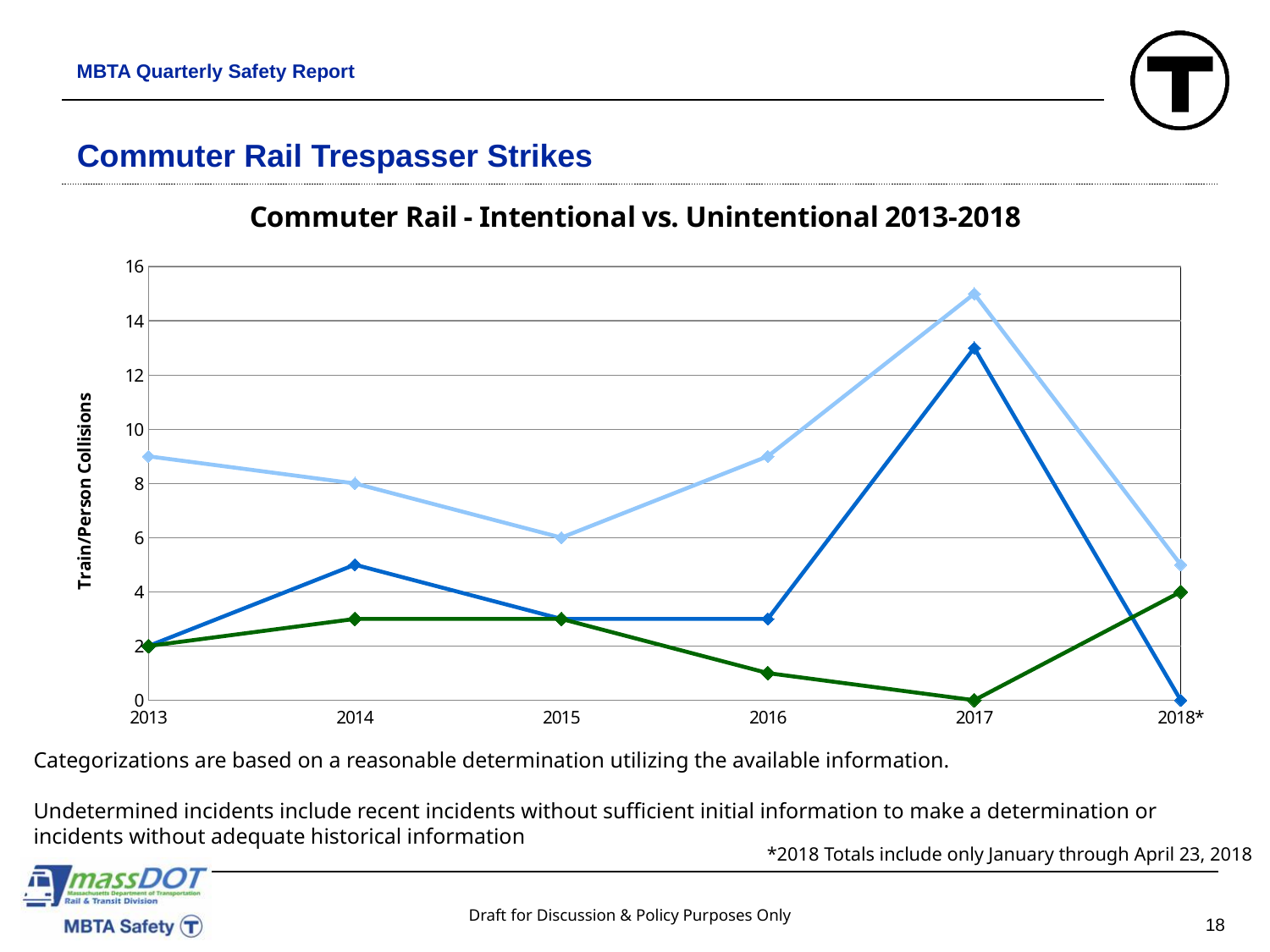
What is the value of the green line in 2018*? 4 How many lines are plotted on the chart? 3 How many years are shown along the x axis of the chart? 6 In which year does the green line reach its lowest value? 2017 In 2016, which line has the higher value, the dark blue line or the green line? dark blue line What is the label on the y axis of the chart? Train/Person Collisions Does the dark blue line rise or fall from 2017 to 2018*? fall In which year does the light blue line reach its highest value? 2017 What kind of chart is shown on the slide? line chart